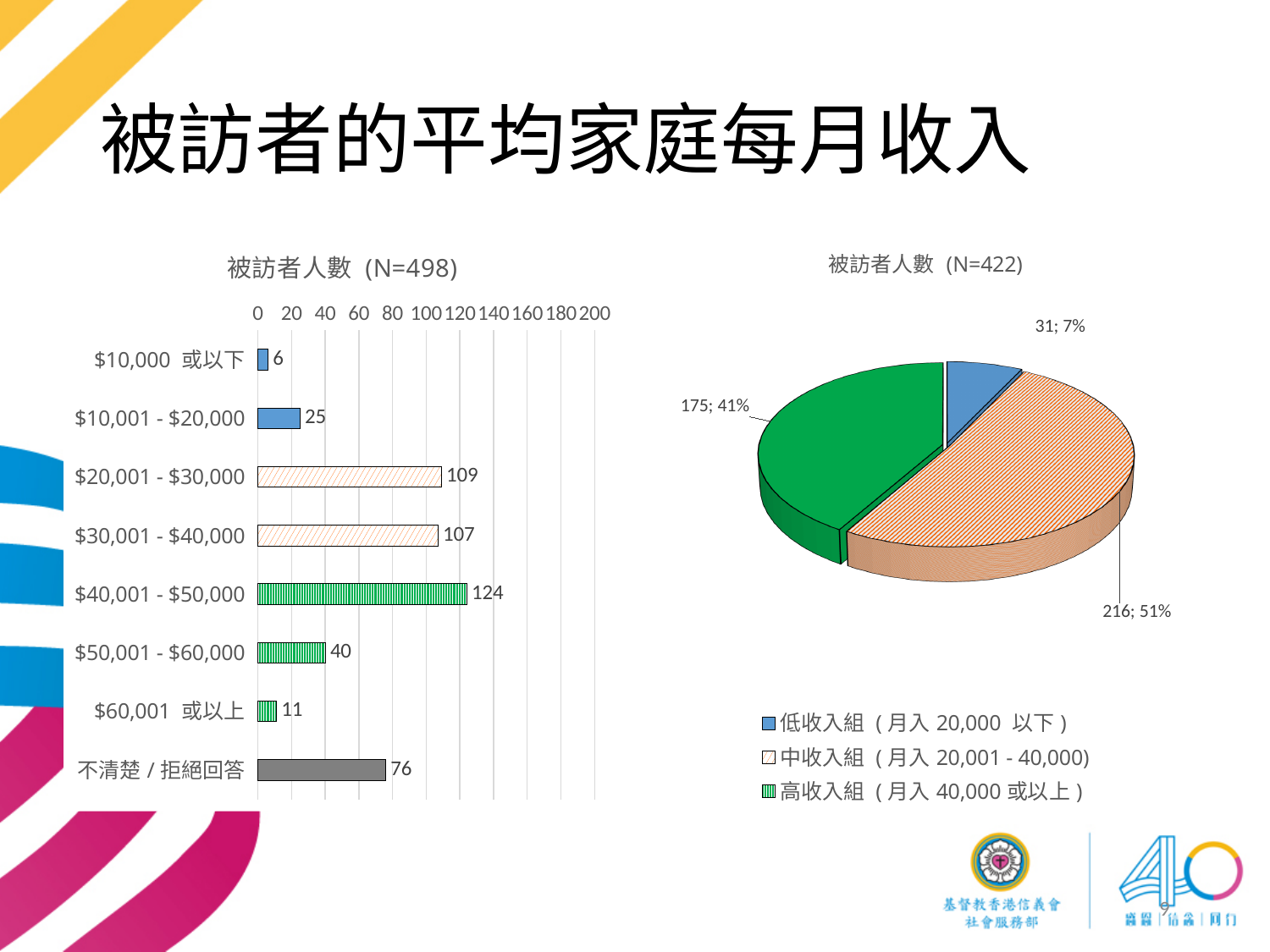
How many entries does the legend of the pie chart titled 被訪者人數 (N=422) list? 3 In the pie chart titled 被訪者人數 (N=422), what is the value for 低收入組 (月入 20,000 以下)? 31 In the pie chart titled 被訪者人數 (N=422), what share does 中收入組 (月入 20,001 - 40,000) have? 51% In the bar chart titled 被訪者人數 (N=498), what is the value for $40,001 - $50,000? 124 In the bar chart titled 被訪者人數 (N=498), which category has the lowest value? $10,000 或以下 In the pie chart titled 被訪者人數 (N=422), which group has the largest slice? 中收入組 (月入 20,001 - 40,000) What kind of chart is the left chart titled 被訪者人數 (N=498)? Bar chart In the bar chart titled 被訪者人數 (N=498), what is the difference between the values for $20,001 - $30,000 and $30,001 - $40,000? 2 In the bar chart titled 被訪者人數 (N=498), which is larger: the value for $50,001 - $60,000 or the value for $10,001 - $20,000? $50,001 - $60,000 In the bar chart titled 被訪者人數 (N=498), what is the value for 不清楚 / 拒絕回答? 76 In the bar chart titled 被訪者人數 (N=498), how many categories are shown? 8 In the bar chart titled 被訪者人數 (N=498), which category has the highest value? $40,001 - $50,000